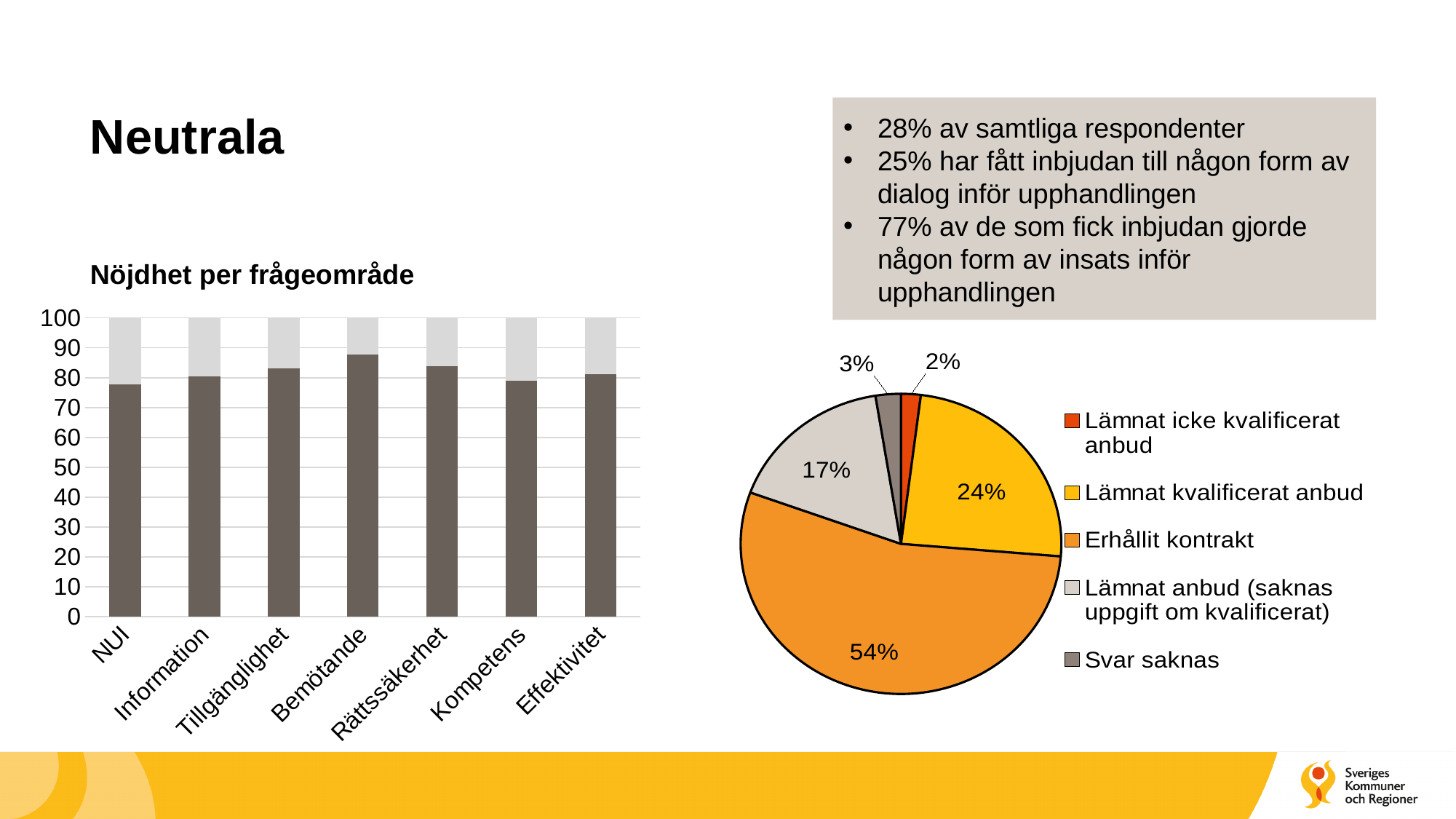
What kind of chart is 'Nöjdhet per frågeområde'? bar chart In the bar chart 'Nöjdhet per frågeområde', is the value for NUI greater or less than 80? less In the pie chart on the right, which is larger: 'Lämnat anbud (saknas uppgift om kvalificerat)' or 'Svar saknas'? Lämnat anbud (saknas uppgift om kvalificerat) In the bar chart 'Nöjdhet per frågeområde', is the value for Bemötande greater or less than 90? less In the pie chart on the right, what is the value for 'Lämnat kvalificerat anbud'? 24% In the bar chart 'Nöjdhet per frågeområde', how many categories are shown on the x axis? 7 In the pie chart on the right, what is the difference between 'Erhållit kontrakt' and 'Lämnat kvalificerat anbud'? 30% In the pie chart on the right, which category has the smallest slice? Lämnat icke kvalificerat anbud In the bar chart 'Nöjdhet per frågeområde', is the value for Bemötande greater or less than 80? greater In the pie chart on the right, how many entries does the legend list? 5 In the pie chart on the right, what share does 'Erhållit kontrakt' have? 54% In the bar chart 'Nöjdhet per frågeområde', which category has the highest value? Bemötande